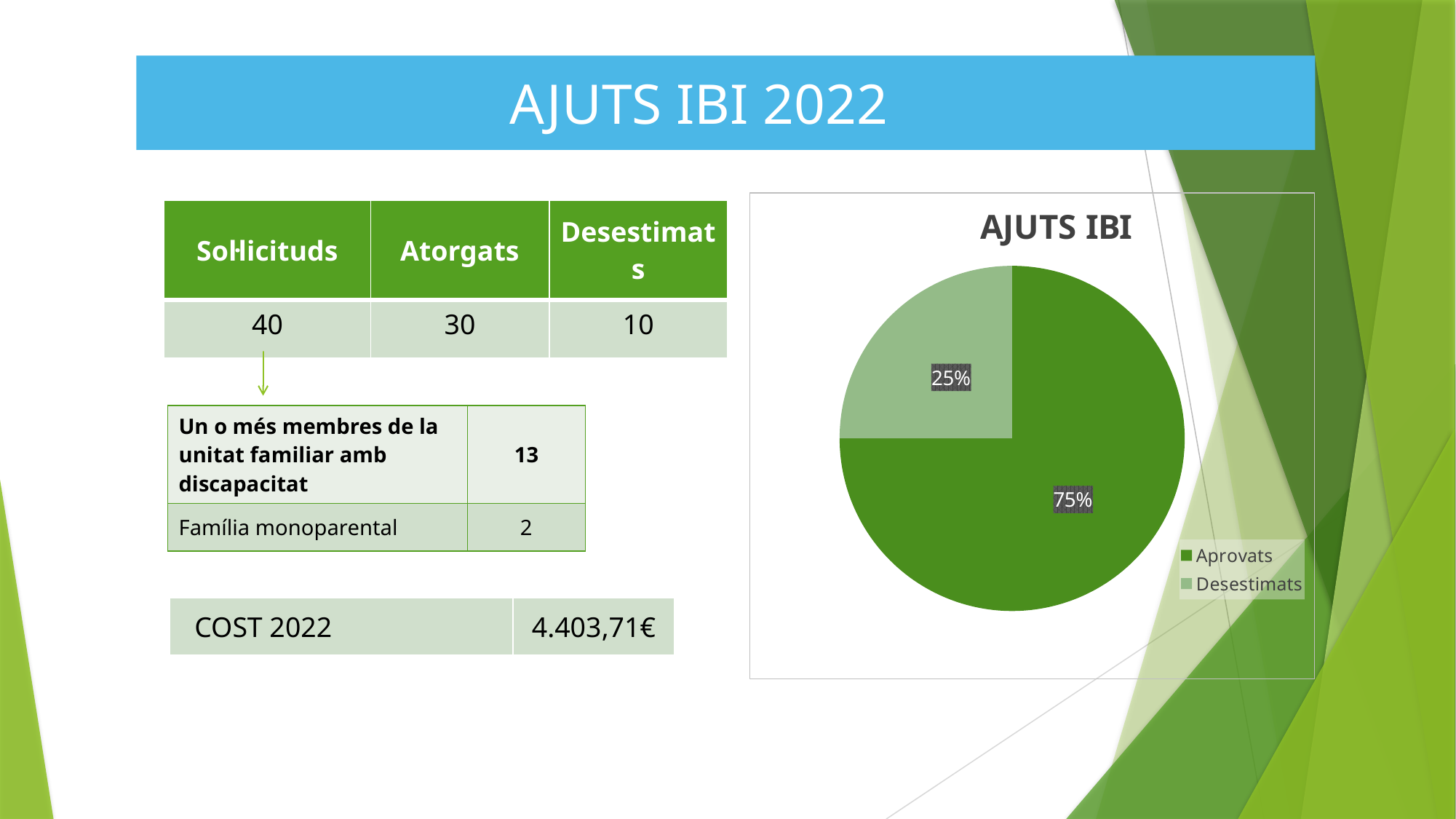
What kind of chart is shown on the slide? pie chart Which is larger, the Aprovats slice or the Desestimats slice? Aprovats How many entries does the chart legend list? 2 Which slice of the pie is the largest? Aprovats Which slice of the pie is the smallest? Desestimats What is the difference in percentage points between the Aprovats and Desestimats slices? 50 percentage points What share of the pie does Aprovats represent? 75% What is the title of the chart? AJUTS IBI What share of the pie does Desestimats represent? 25% Which legend entry is shown in the lighter green colour? Desestimats How many slices does the pie chart have? 2